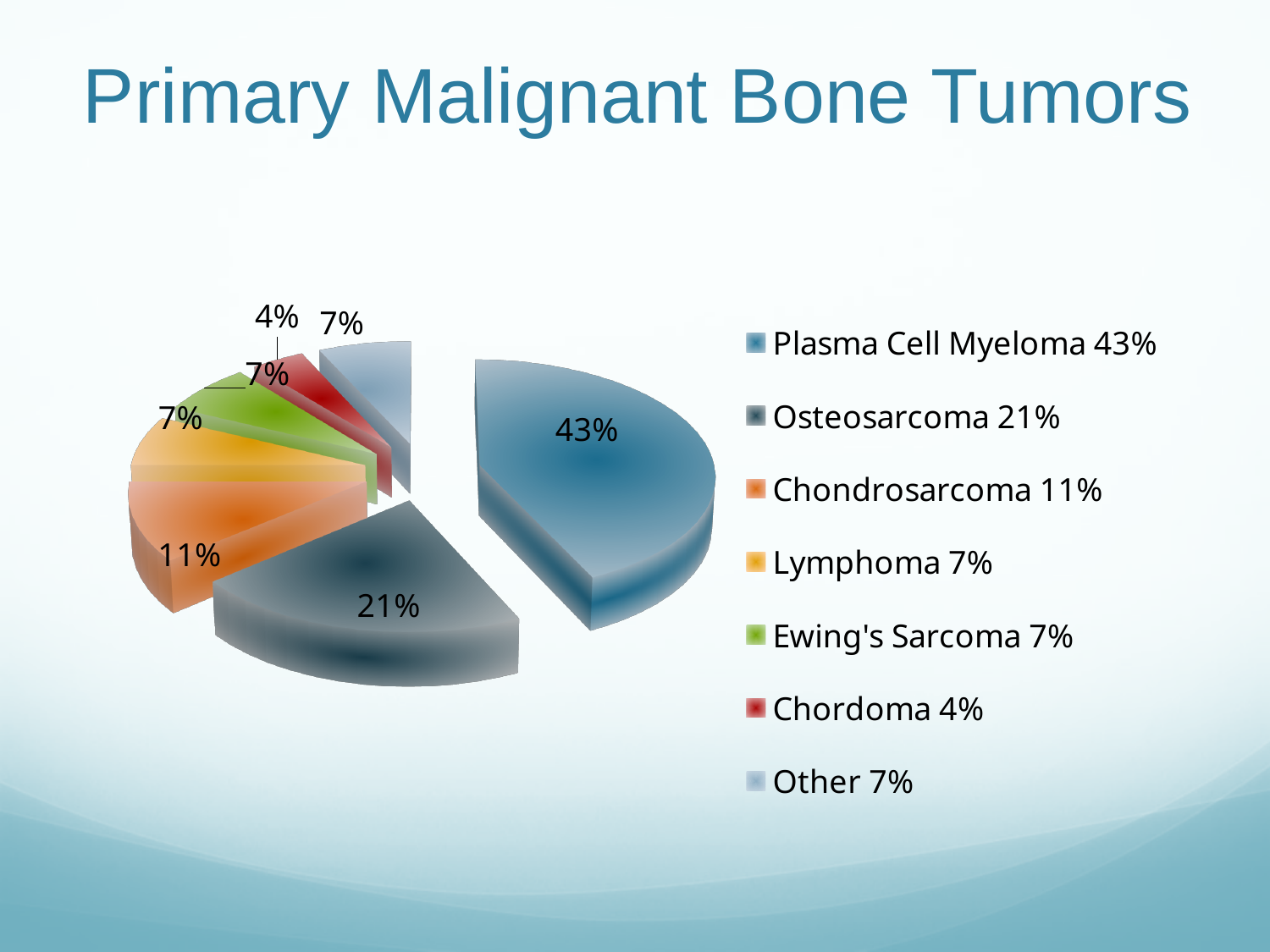
What kind of chart is shown on the slide? Pie chart What is the combined share of Lymphoma and Ewing's Sarcoma? 14% What is the value shown for Chondrosarcoma? 11% Which is larger, the share for Chondrosarcoma or the share for Lymphoma? Chondrosarcoma What is the value shown for Chordoma? 4% How many categories does the legend list? 7 What is the value shown for Osteosarcoma? 21% Which category has the largest slice of the pie? Plasma Cell Myeloma What is the difference between the Plasma Cell Myeloma and Osteosarcoma shares? 22% What share of the pie does Plasma Cell Myeloma represent? 43% What is the title of the slide containing the chart? Primary Malignant Bone Tumors Which category has the smallest slice of the pie? Chordoma